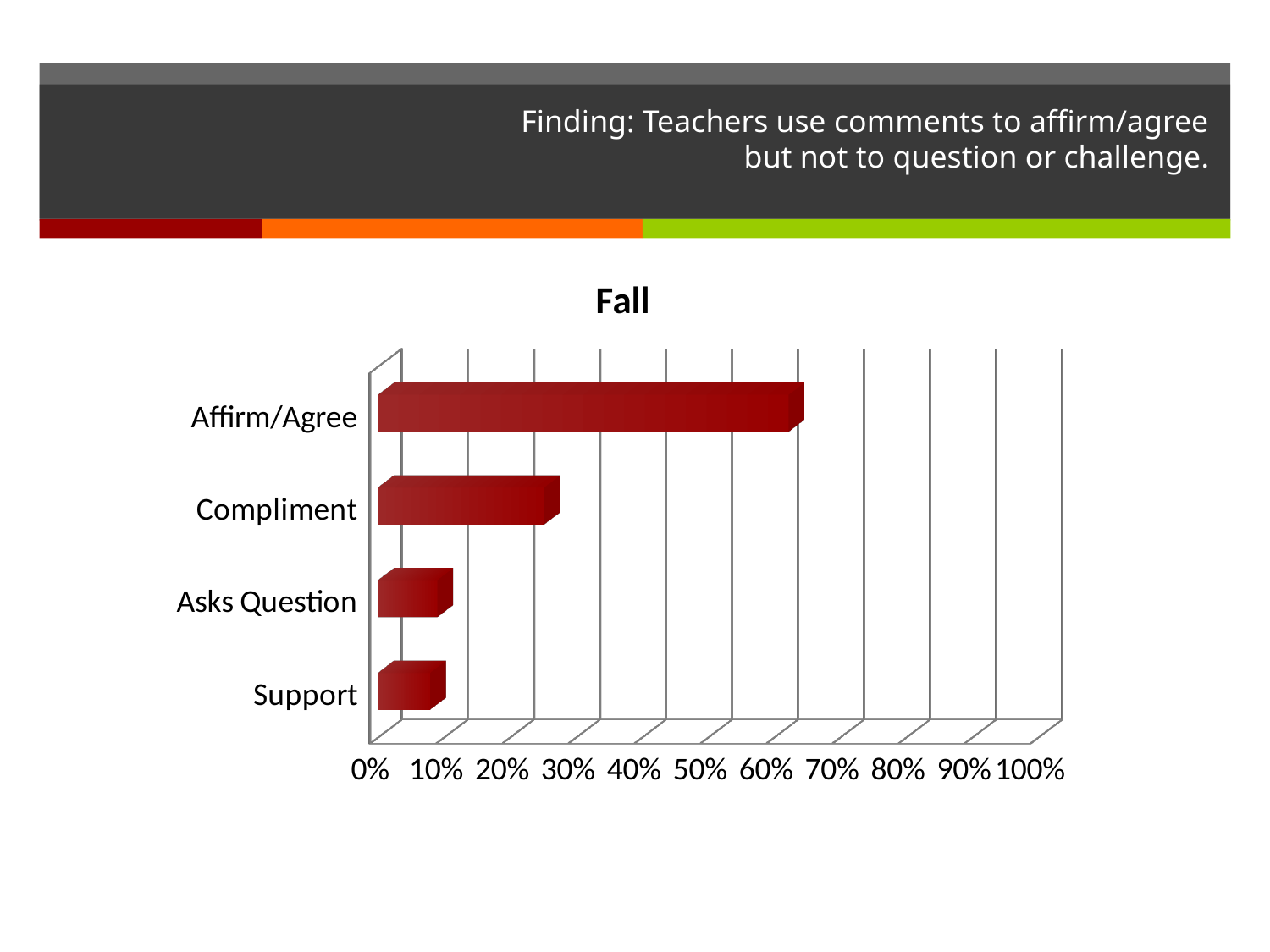
What is the title of the chart? Fall What kind of chart is shown on the slide? Bar chart Which is larger, the value for Compliment or the value for Asks Question? Compliment Which is larger, the value for Affirm/Agree or the value for Compliment? Affirm/Agree Is the value for Support greater or less than 20%? less How many categories are plotted in the chart? 4 Is the value for Affirm/Agree greater or less than 70%? less Which category has the highest value in the chart? Affirm/Agree Is the value for Asks Question greater or less than 20%? less